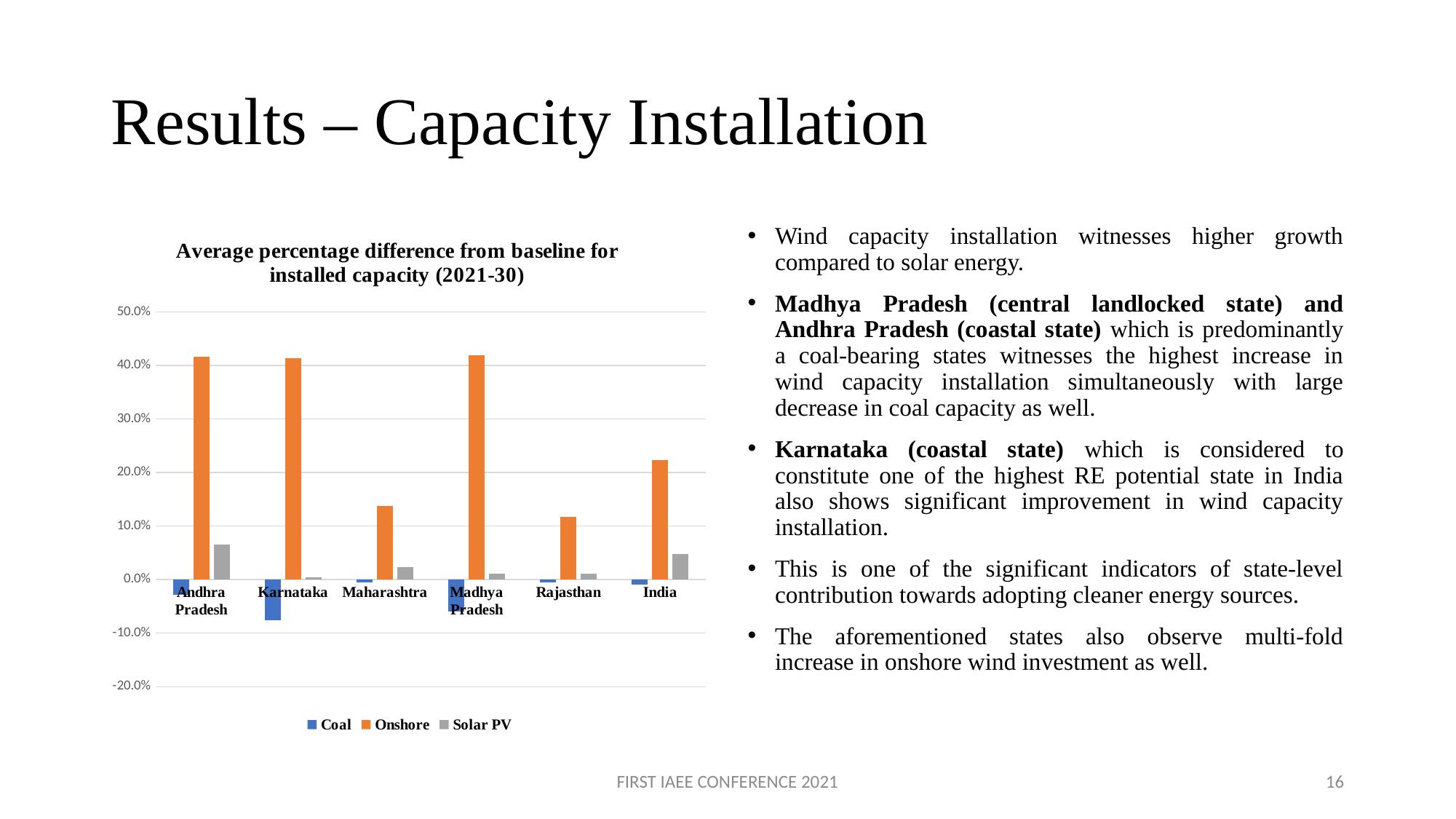
Which category has the highest Solar PV value? Andhra Pradesh Which category has the lowest (most negative) Coal value? Karnataka What kind of chart is shown on the slide? bar chart Is the Onshore value for Maharashtra greater or less than 10.0%? greater Which category has the lowest Onshore value? Rajasthan What is the title of the chart? Average percentage difference from baseline for installed capacity (2021-30) Is the Onshore value for India greater or less than 20.0%? greater Is the Onshore value for Karnataka greater or less than 40.0%? greater Which is larger, the Onshore value for Maharashtra or the Onshore value for India? India How many categories (states/regions) are shown on the x axis? 6 How many series does the legend list? 3